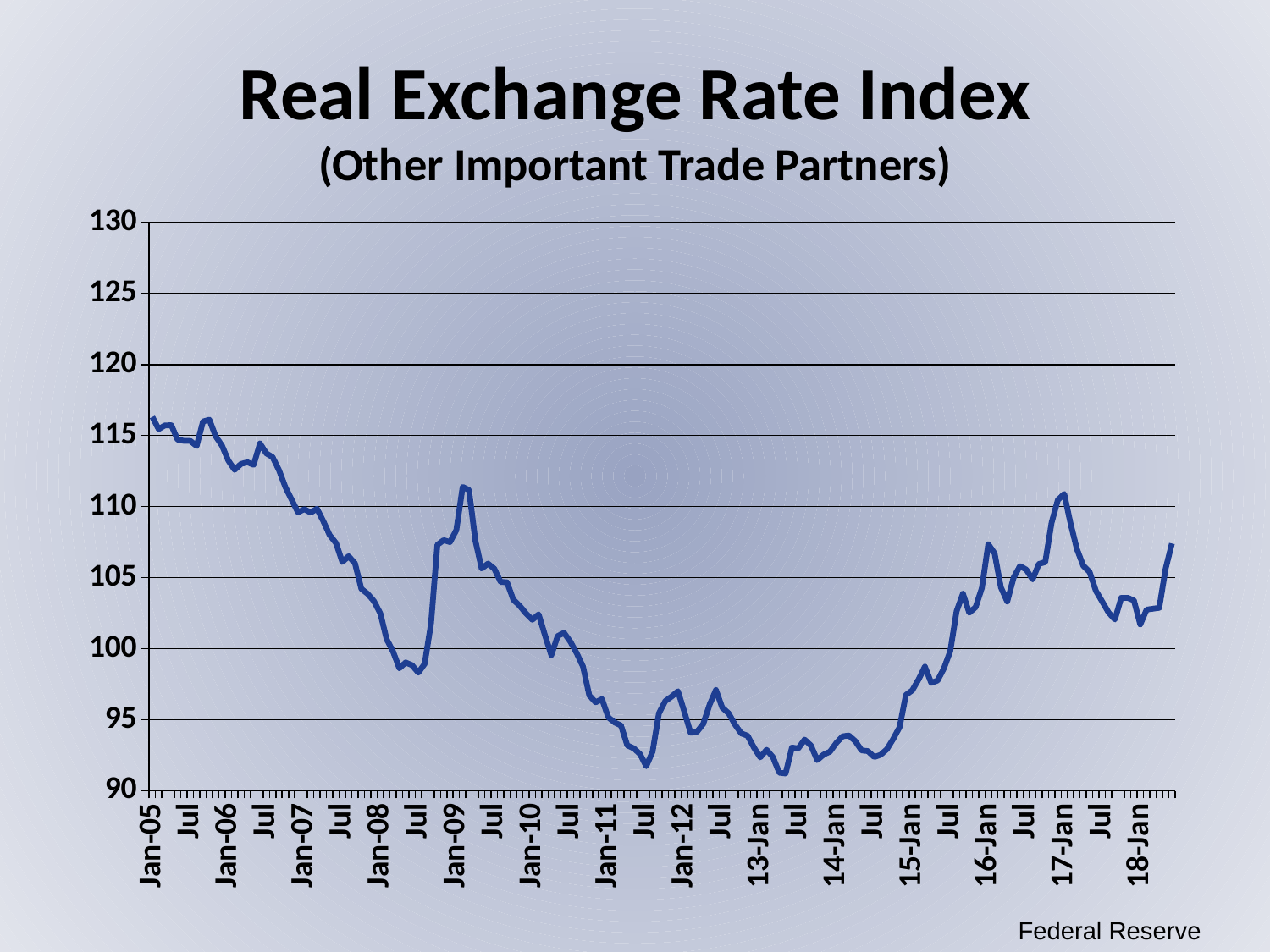
How many lines are plotted on the chart? 1 Does the index rise or fall between 13-Jan and 17-Jan? rise What source is cited at the bottom of the slide? Federal Reserve What kind of chart is shown on the slide? line chart Is the value at 13-Jan greater or less than 95? less Is the value at Jul-11 greater or less than 95? less Is the value at 17-Jan greater or less than 105? greater Which is larger, the value at Jan-06 or the value at Jul-11? Jan-06 What is the title of the chart? Real Exchange Rate Index (Other Important Trade Partners) Does the index rise or fall between Jan-05 and Jul-11? fall